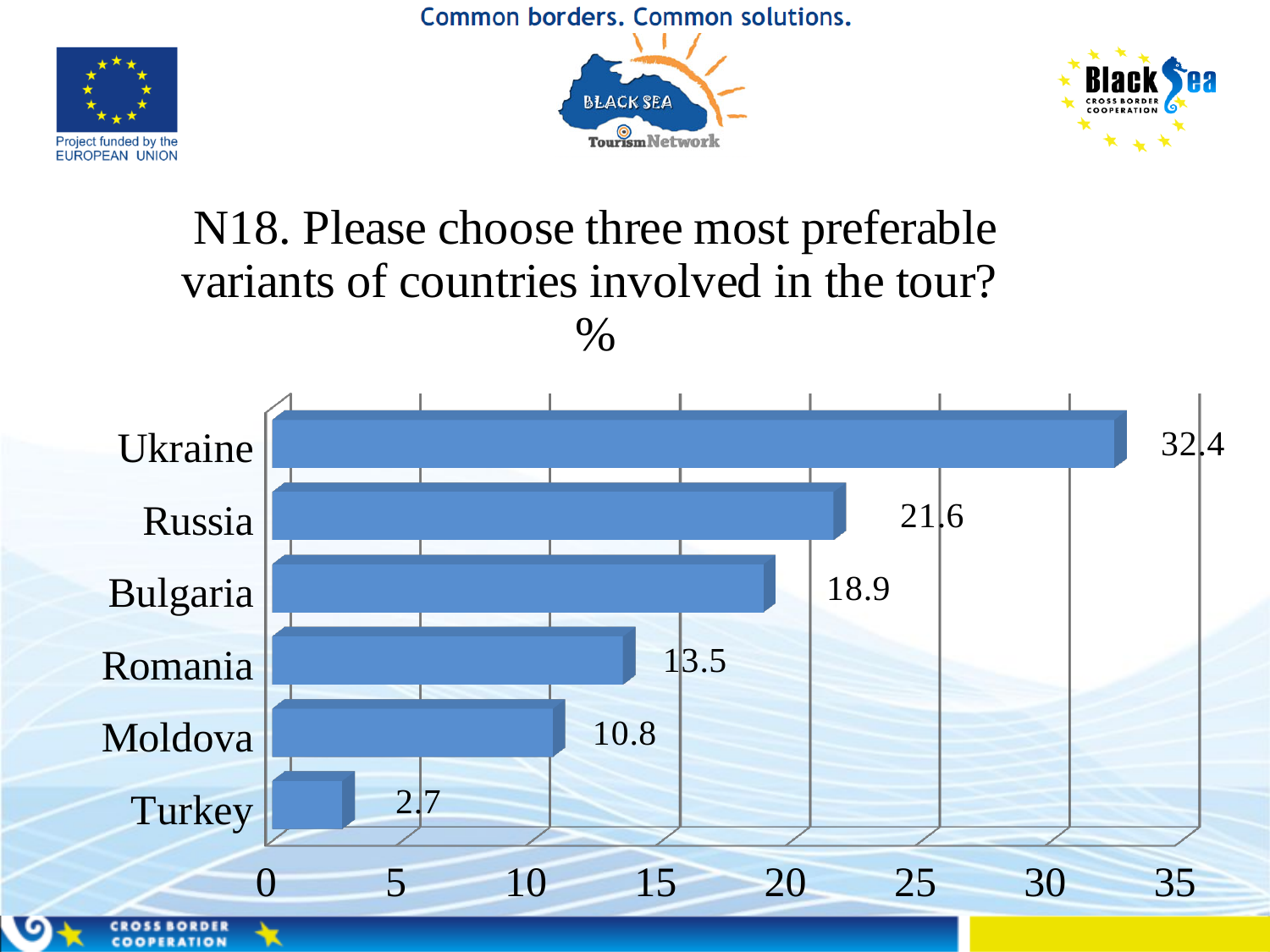
What is the value for Moldova? 10.8 Which is larger, the value for Russia or the value for Bulgaria? Russia What is the value for Bulgaria? 18.9 What is the value for Ukraine? 32.4 What is the difference between the values for Ukraine and Russia? 10.8 How many countries are shown in the chart? 6 Is the value for Romania greater or less than 15? less What kind of chart is shown on the slide? bar chart Which country has the lowest value? Turkey Which country has the highest value? Ukraine What is the difference between the values for Romania and Turkey? 10.8 What is the maximum value shown on the horizontal axis? 35